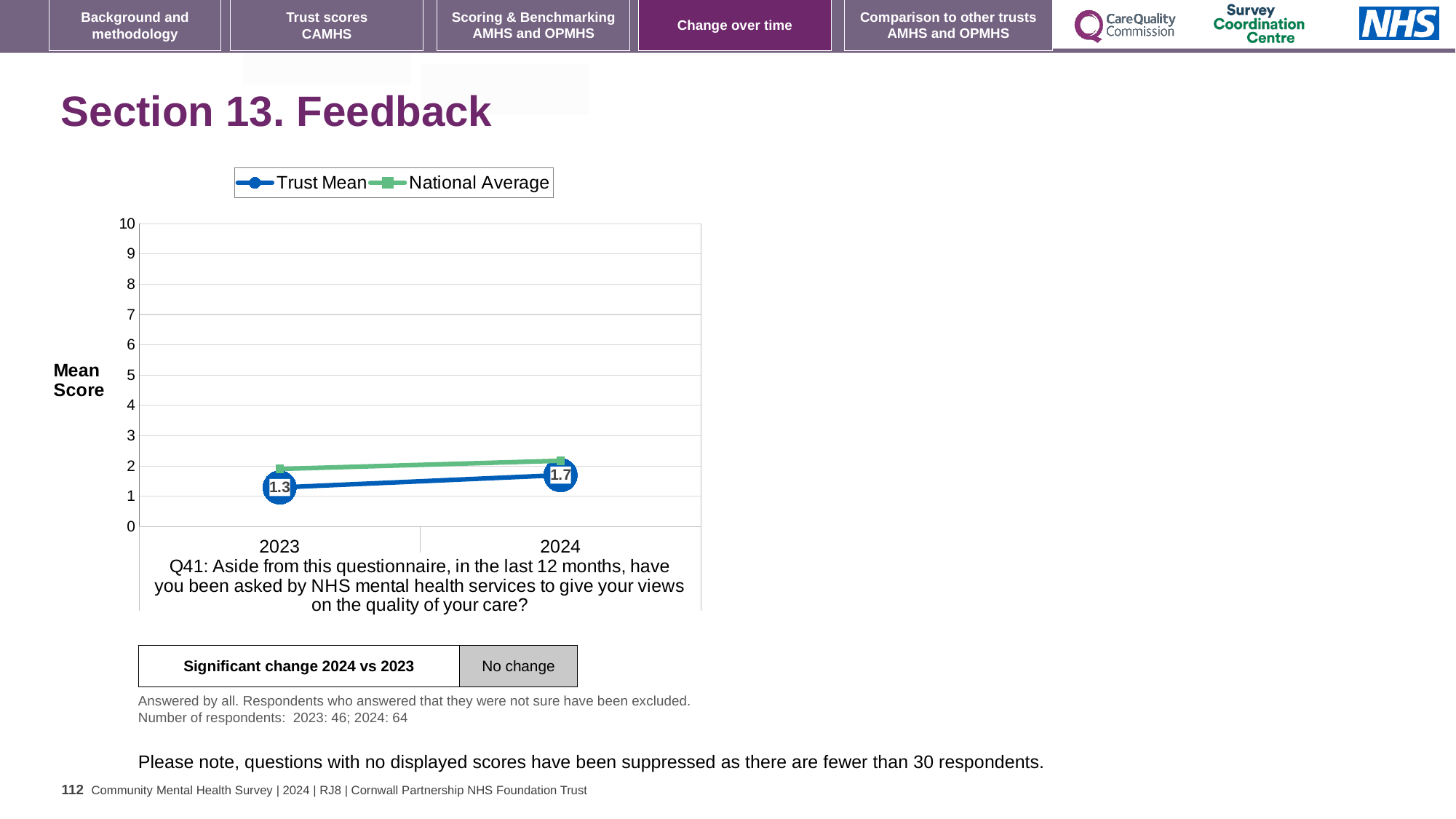
Does the Trust Mean score rise or fall from 2023 to 2024? rise By how much did the Trust Mean score change from 2023 to 2024? 0.4 What is the Trust Mean score for 2024? 1.7 Is the National Average value for 2023 greater or less than 3? less In 2024, which series is higher, Trust Mean or National Average? National Average Which year has the higher Trust Mean score, 2023 or 2024? 2024 What is the Trust Mean score for 2023? 1.3 What kind of chart is shown on the slide? line chart In 2023, which series is higher, Trust Mean or National Average? National Average Is the National Average value for 2024 greater or less than 1? greater How many years are plotted on the x axis of the chart? 2 How many series does the chart legend list? 2